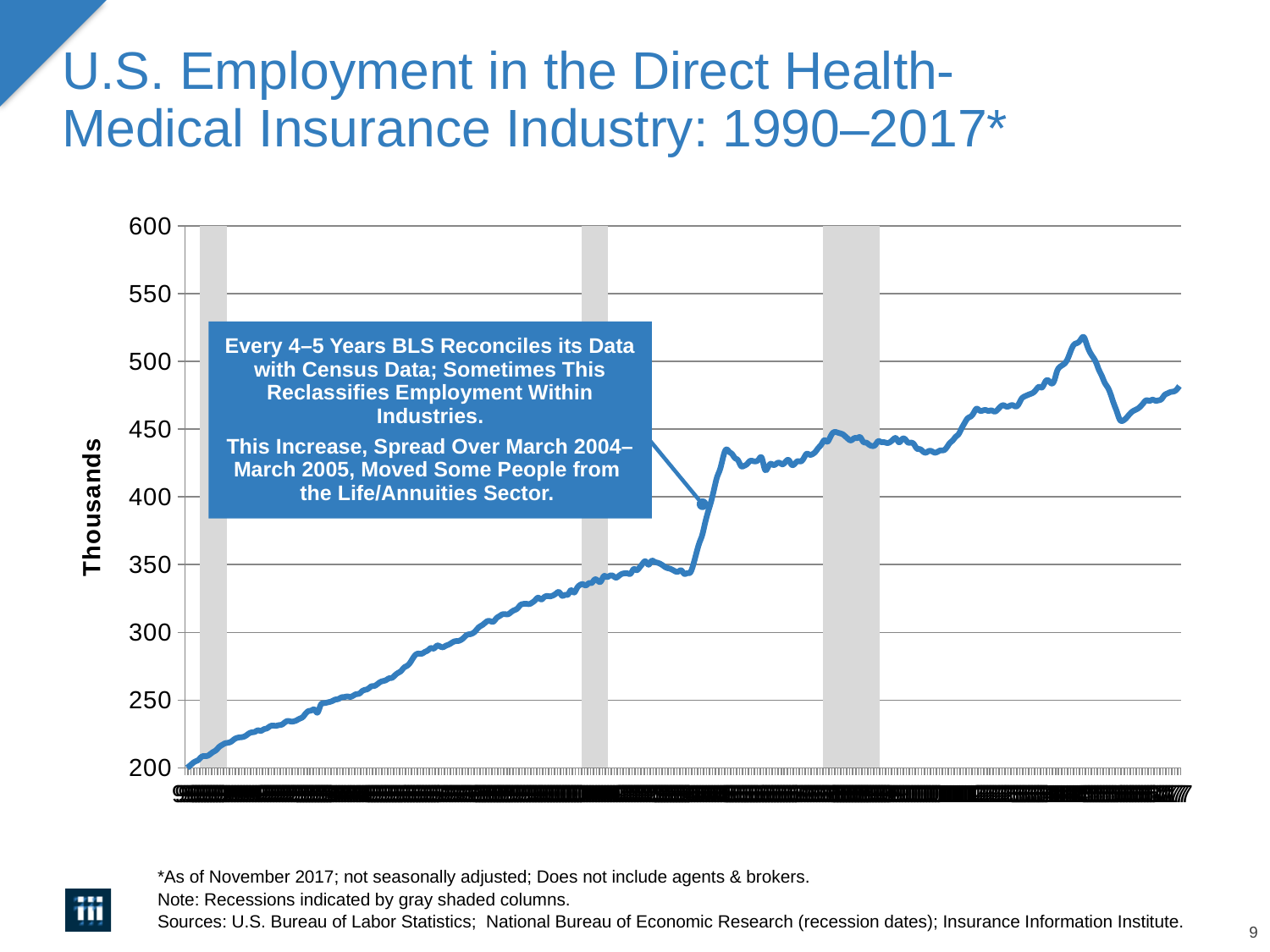
What is the title of the chart on the slide? U.S. Employment in the Direct Health-Medical Insurance Industry: 1990–2017* Is the highest point reached by the line greater or less than 500? greater Is the value at the right-hand end of the line greater or less than 500? less How many gray shaded recession columns are shown on the chart? 3 What is the label on the vertical axis of the chart? Thousands Is the value at the left-hand start of the line greater or less than the value at the right-hand end? less Is the value at the right-hand end of the line greater or less than 450? greater Overall, do the values rise or fall from the left to the right of the chart? rise What kind of chart is shown on the slide? line chart What is the highest value shown on the vertical axis of the chart? 600